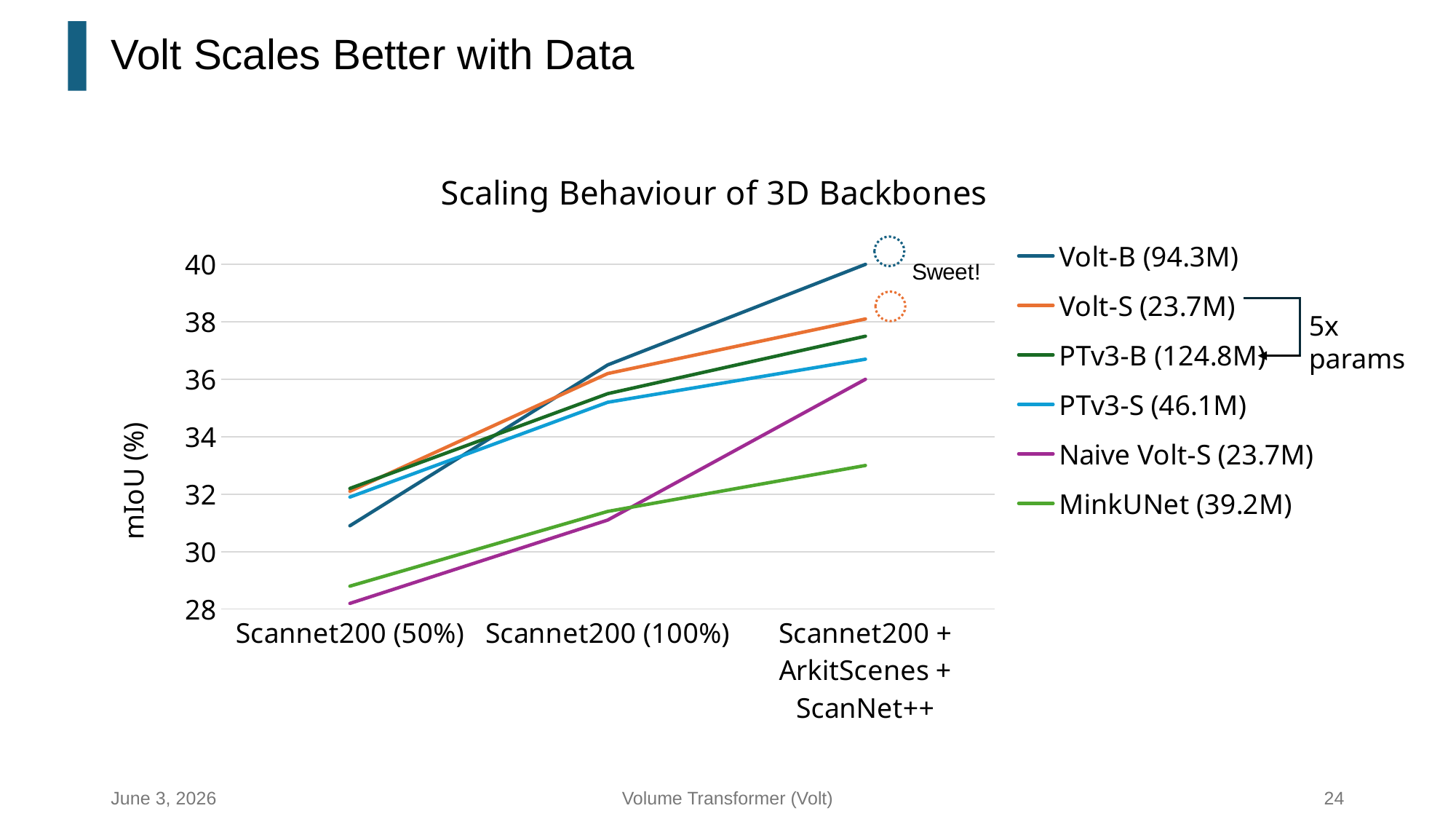
How many categories are shown on the x axis? 3 Is the value for Volt-B (94.3M) at Scannet200 (50%) greater or less than 32? less Is the value for MinkUNet (39.2M) at Scannet200 + ArkitScenes + ScanNet++ greater or less than 34? less What is the label of the y axis? mIoU (%) Which series has the highest value at Scannet200 + ArkitScenes + ScanNet++? Volt-B (94.3M) How many series does the legend list? 6 What kind of chart is shown on the slide? line chart Do the values for Volt-B (94.3M) rise or fall from Scannet200 (50%) to Scannet200 + ArkitScenes + ScanNet++? rise Which series has the lowest value at Scannet200 + ArkitScenes + ScanNet++? MinkUNet (39.2M) Which is larger at Scannet200 (50%): Volt-B (94.3M) or PTv3-S (46.1M)? PTv3-S (46.1M) Is the value for Naive Volt-S (23.7M) at Scannet200 (50%) greater or less than 30? less What is the title of the chart? Scaling Behaviour of 3D Backbones